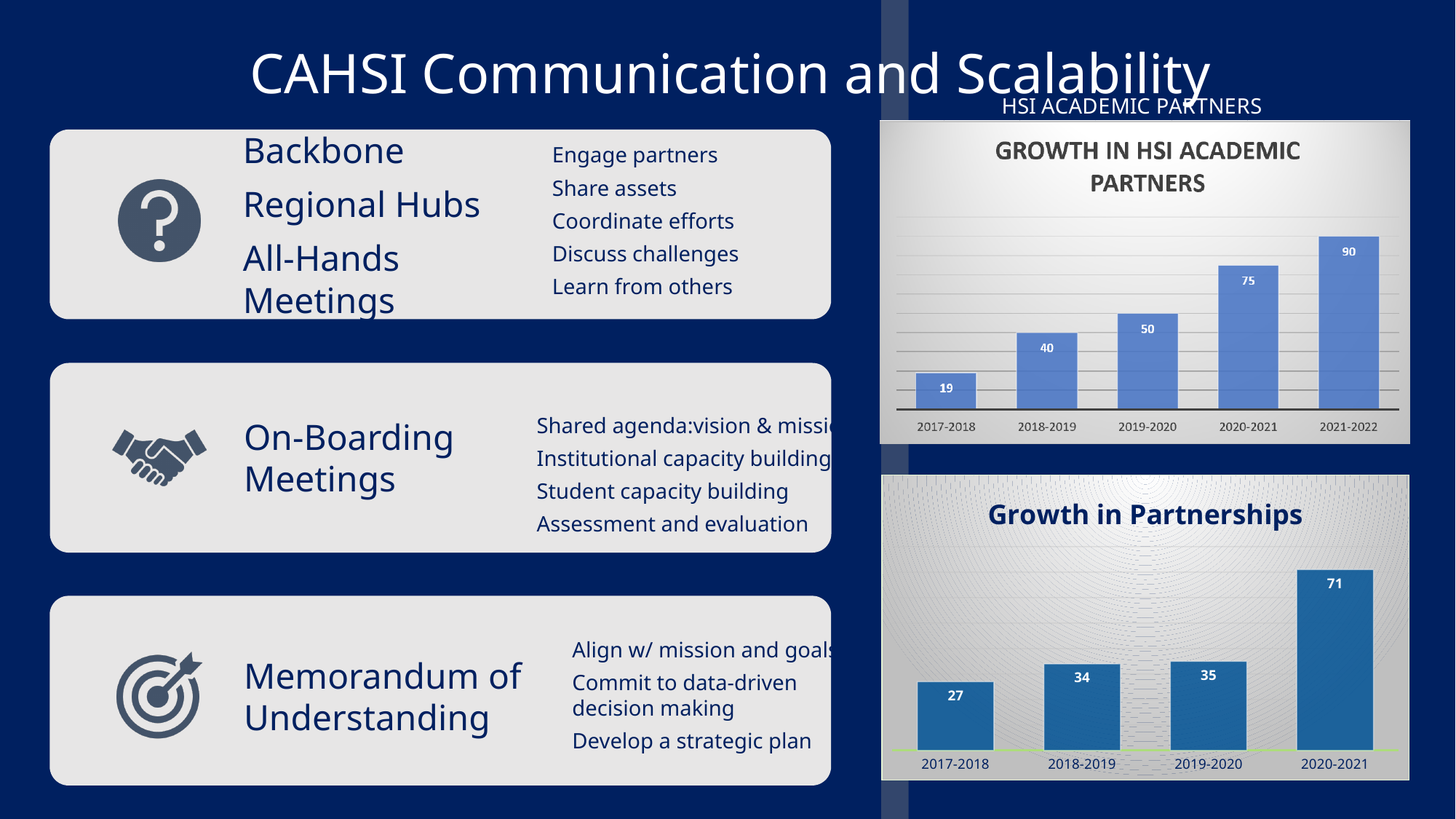
What kind of chart is the 'Growth in Partnerships' chart? bar chart In the 'Growth in Partnerships' chart, what is the value for 2020-2021? 71 In the 'Growth in HSI Academic Partners' chart, what is the value for 2017-2018? 19 In the 'Growth in HSI Academic Partners' chart, do the values rise or fall from 2017-2018 to 2021-2022? rise In the 'Growth in Partnerships' chart, which year has the lowest value? 2017-2018 In the 'Growth in HSI Academic Partners' chart, which year has the highest value? 2021-2022 In the 'Growth in HSI Academic Partners' chart, what is the difference between the 2021-2022 and 2020-2021 values? 15 Which is larger: the 2018-2019 value in the 'Growth in HSI Academic Partners' chart or the 2018-2019 value in the 'Growth in Partnerships' chart? Growth in HSI Academic Partners (40) In the 'Growth in Partnerships' chart, how many years are shown? 4 In the 'Growth in HSI Academic Partners' chart, what is the value for 2019-2020? 50 In the 'Growth in HSI Academic Partners' chart, how many years are shown? 5 In the 'Growth in Partnerships' chart, what is the difference between the 2020-2021 and 2019-2020 values? 36